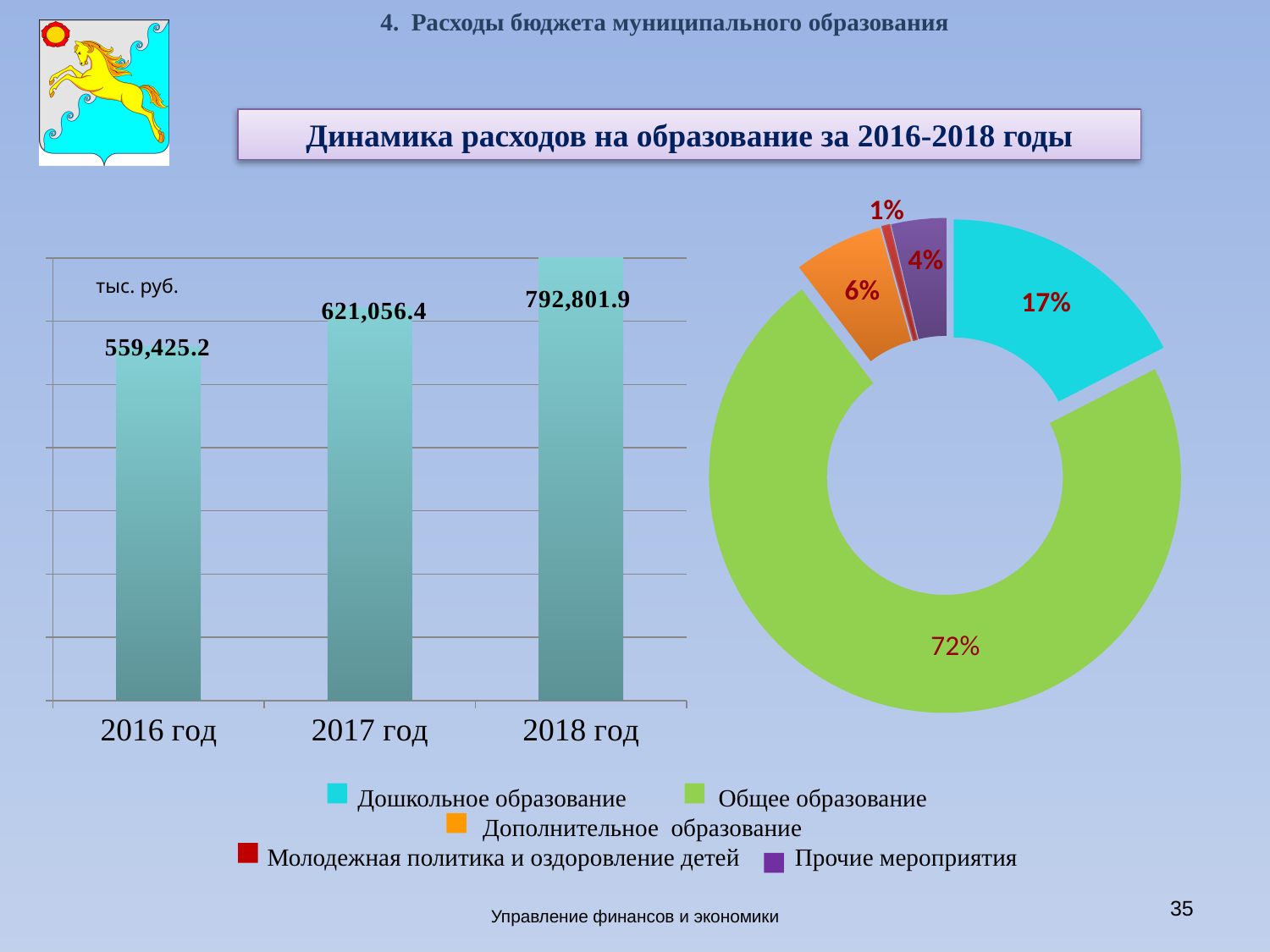
On the bar chart on the left, do the values rise or fall from 2016 год to 2018 год? rise On the bar chart on the left, which year has the lowest value? 2016 год On the doughnut chart on the right, what share does Общее образование have? 72% On the bar chart on the left, which year has the highest value? 2018 год On the doughnut chart on the right, what share does Дошкольное образование have? 17% How many entries does the legend of the doughnut chart list? 5 What kind of chart is the chart on the left of the slide? bar chart On the bar chart on the left, what is the value for 2017 год? 621,056.4 On the doughnut chart on the right, which category has the smallest share? Молодежная политика и оздоровление детей On the bar chart on the left, how many years are shown? 3 On the bar chart on the left, what is the difference between the values for 2018 год and 2016 год? 233,376.7 On the bar chart on the left, what is the value for 2016 год? 559,425.2